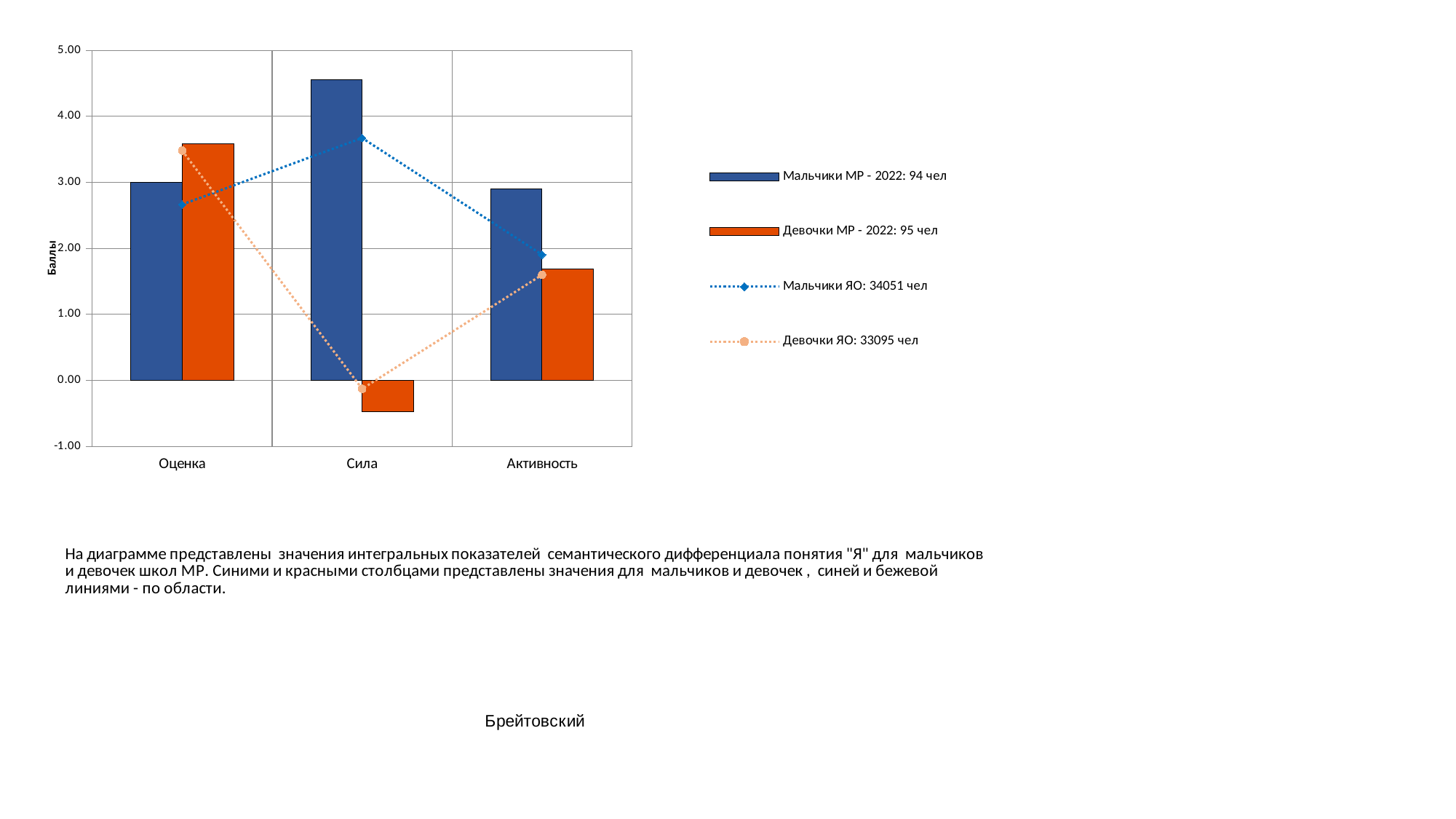
For which category is the bar for Девочки МР - 2022 the lowest? Сила Is the value for Мальчики МР - 2022 in Сила greater or less than 4.00? greater For which category is the bar for Девочки МР - 2022 the highest? Оценка What is the title of the vertical axis? Баллы In the Активность category, which bar is larger: Мальчики МР - 2022 or Девочки МР - 2022? Мальчики МР - 2022 Is the value for Девочки МР - 2022 in Сила greater or less than 0.00? less For which category is the bar for Мальчики МР - 2022 the highest? Сила Is the value for Девочки МР - 2022 in Активность greater or less than 2.00? less How many categories are shown on the x axis? 3 How many series does the legend list? 4 In the Оценка category, which bar is larger: Мальчики МР - 2022 or Девочки МР - 2022? Девочки МР - 2022 What kind of chart is shown on the slide? bar chart with dotted line series